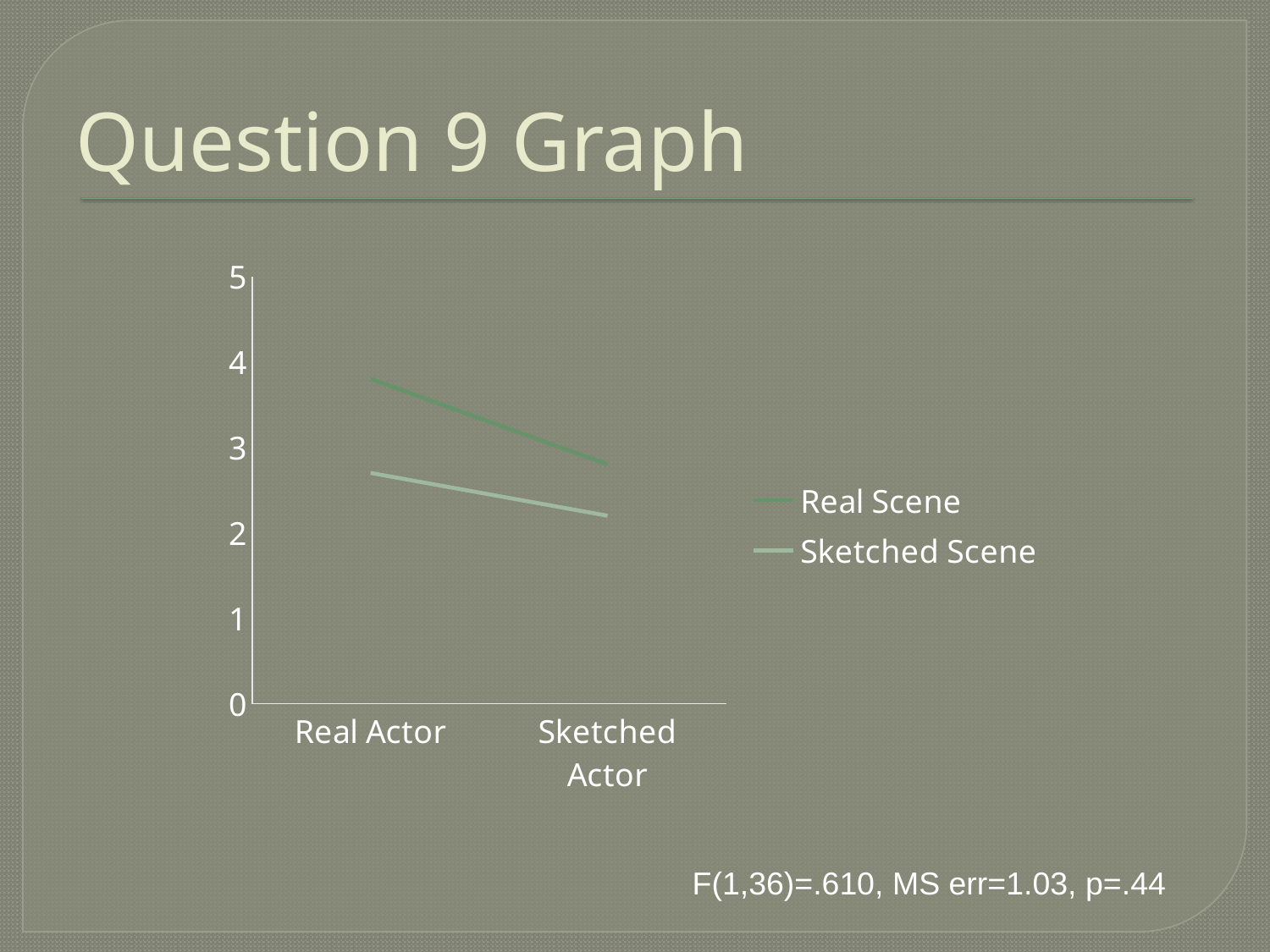
What are the two series named in the legend? Real Scene and Sketched Scene Is the Sketched Scene value for Sketched Actor greater or less than 3? less At Sketched Actor, which series has the higher value, Real Scene or Sketched Scene? Real Scene How many series does the legend list? 2 How many categories are shown on the x axis? 2 What is the title of the slide containing the chart? Question 9 Graph Does the Real Scene line rise or fall from Real Actor to Sketched Actor? fall Does the Sketched Scene line rise or fall from Real Actor to Sketched Actor? fall At Real Actor, which series has the higher value, Real Scene or Sketched Scene? Real Scene Is the Sketched Scene value for Real Actor greater or less than 3? less What kind of chart is shown on the slide? line chart Is the Real Scene value for Real Actor greater or less than 3? greater